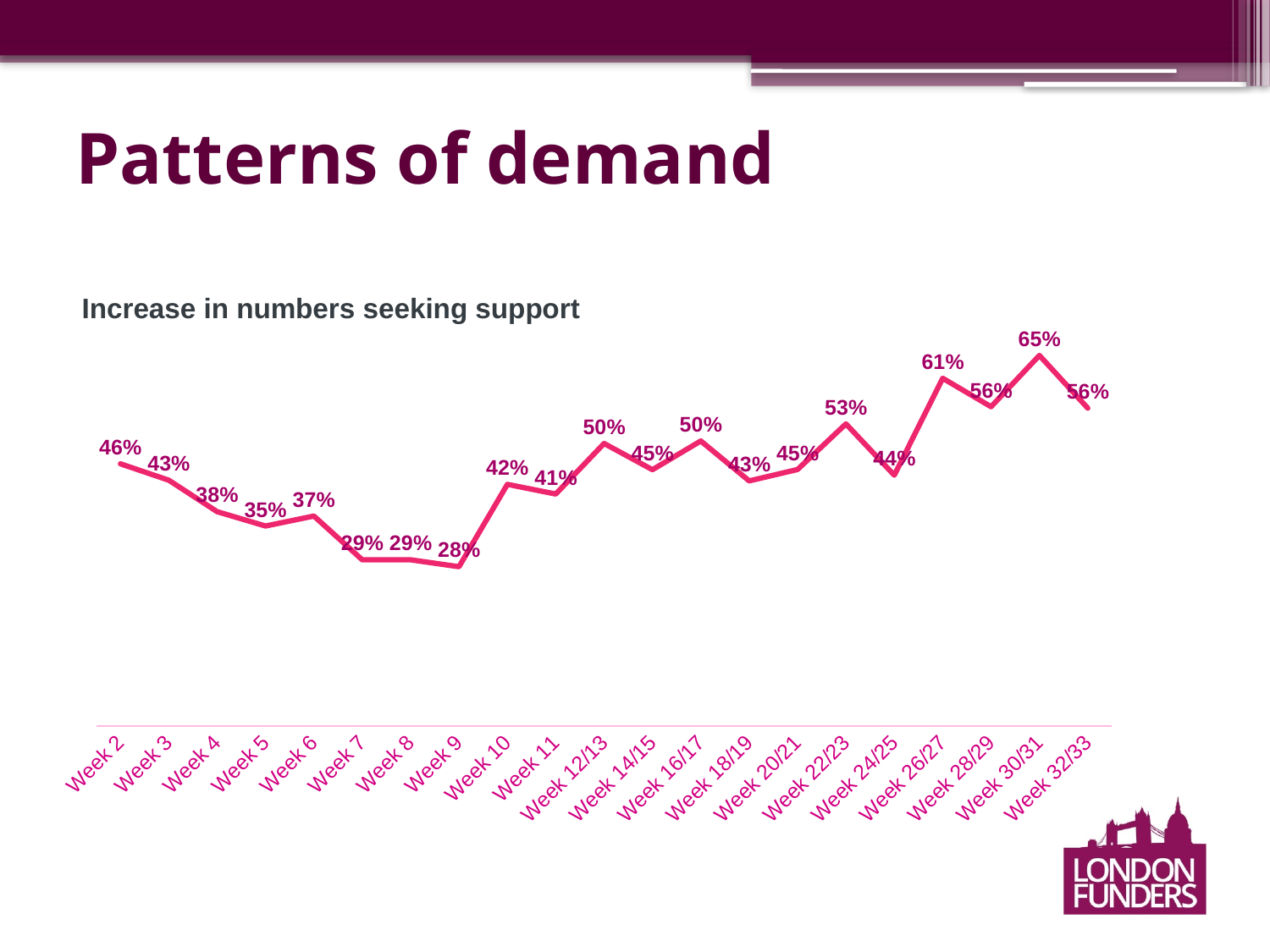
What is the value for Week 9? 28% How many weeks (data points) are plotted on the chart? 21 What is the value for Week 26/27? 61% Which week has the highest value? Week 30/31 Overall, do the values rise or fall from Week 2 to Week 32/33? Rise What is the difference between the values for Week 10 and Week 9? 14% What is the title of the chart? Increase in numbers seeking support What is the difference between the values for Week 30/31 and Week 9? 37% What kind of chart is shown on the slide? Line chart Which week has the lowest value? Week 9 Which is larger, the value for Week 22/23 or the value for Week 24/25? Week 22/23 What is the value for Week 2? 46%